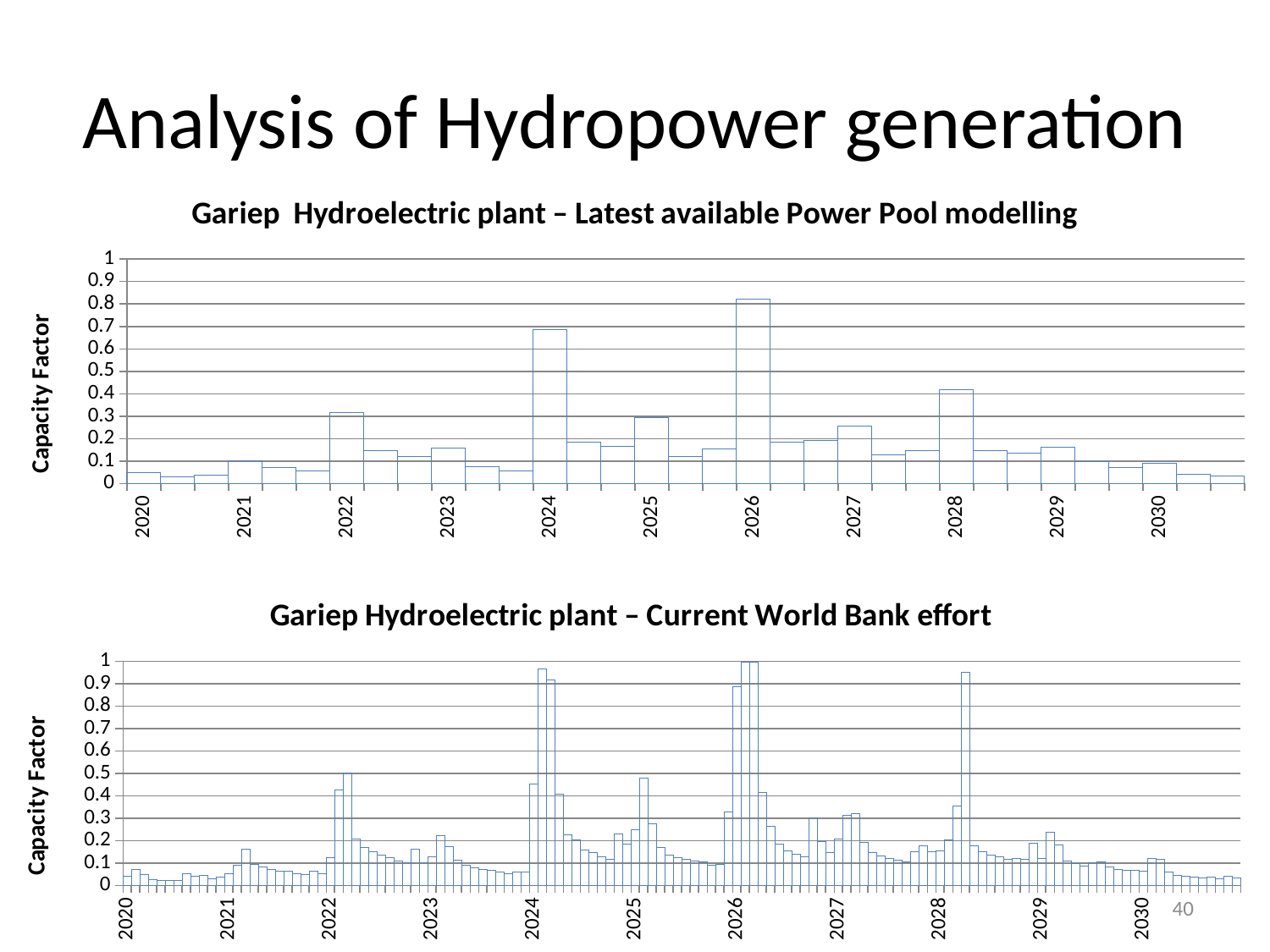
In the top chart (Latest available Power Pool modelling), which is taller: the highest bar in 2024 or the highest bar in 2026? 2026 In the bottom chart (Current World Bank effort), is the tallest bar in 2024 greater or less than 0.9? greater How many year labels are shown on the x axis of the top chart (Latest available Power Pool modelling)? 11 In the top chart (Latest available Power Pool modelling), is the tallest bar in 2026 greater or less than 0.7? greater In the bottom chart (Current World Bank effort), which is taller: the highest bar in 2022 or the highest bar in 2027? 2022 What kind of chart is the top chart, 'Gariep Hydroelectric plant – Latest available Power Pool modelling'? Bar chart What is the y-axis label of the bottom chart (Current World Bank effort)? Capacity Factor In the bottom chart (Current World Bank effort), is the tallest bar in 2027 greater or less than 0.5? less In the top chart (Latest available Power Pool modelling), which year contains the highest bar? 2026 In the bottom chart (Current World Bank effort), which year contains the highest bars? 2026